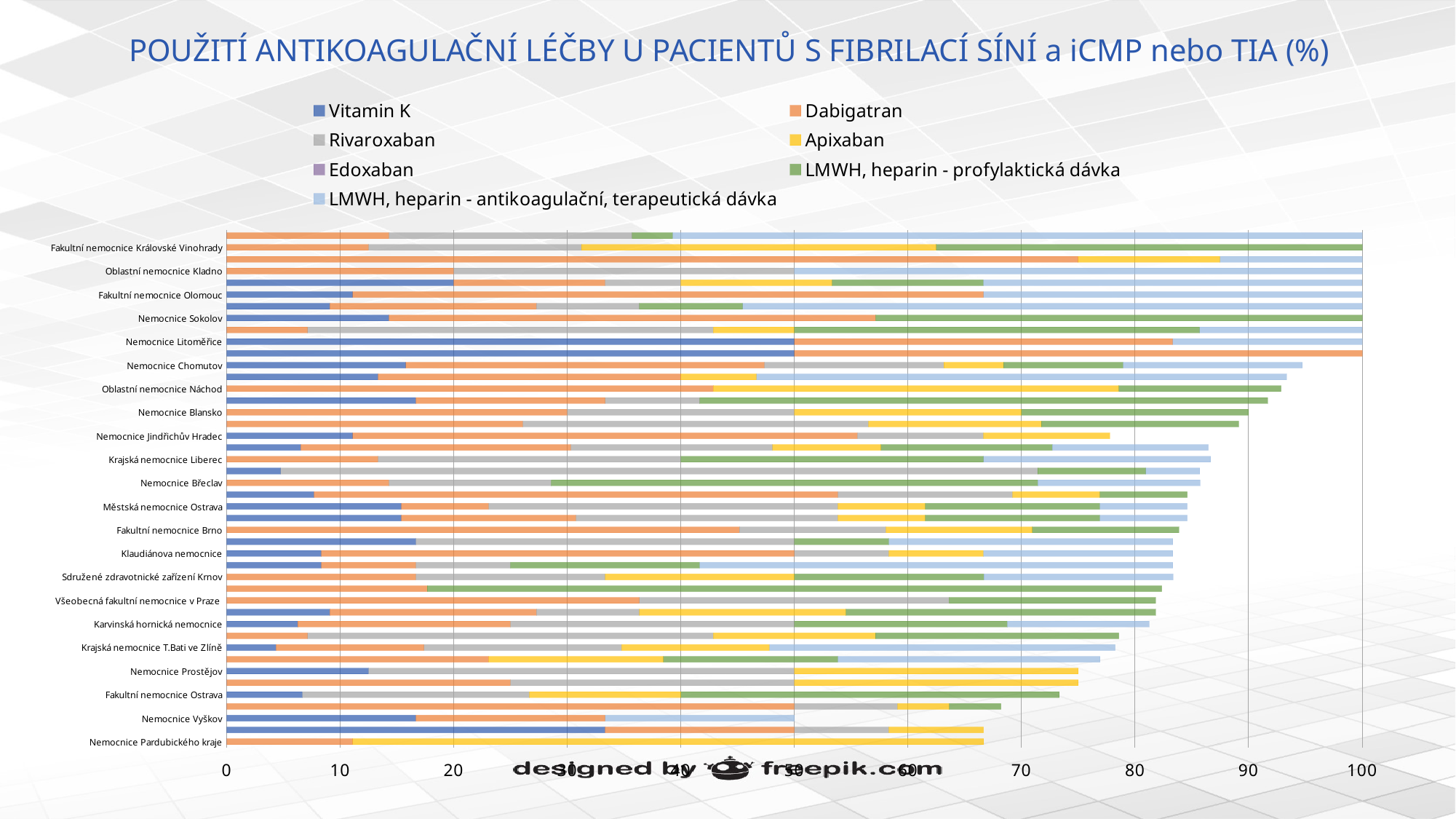
Which has the longer total bar: Nemocnice Pardubického kraje or Nemocnice Vyškov? Nemocnice Pardubického kraje Is the total bar length for Nemocnice Prostějov greater or less than 80? less Is the total bar length for Oblastní nemocnice Náchod greater or less than 90? greater Which colour represents Apixaban in the legend? yellow Is the total bar length for Nemocnice Litoměřice greater or less than 90? greater Which hospital has the shortest total bar in the chart? Nemocnice Vyškov What is the title of the chart? POUŽITÍ ANTIKOAGULAČNÍ LÉČBY U PACIENTŮ S FIBRILACÍ SÍNÍ a iCMP nebo TIA (%) Do the total bar lengths generally increase or decrease going from the top of the chart to the bottom? decrease What kind of chart is shown on the slide? bar chart How many series does the legend list? 7